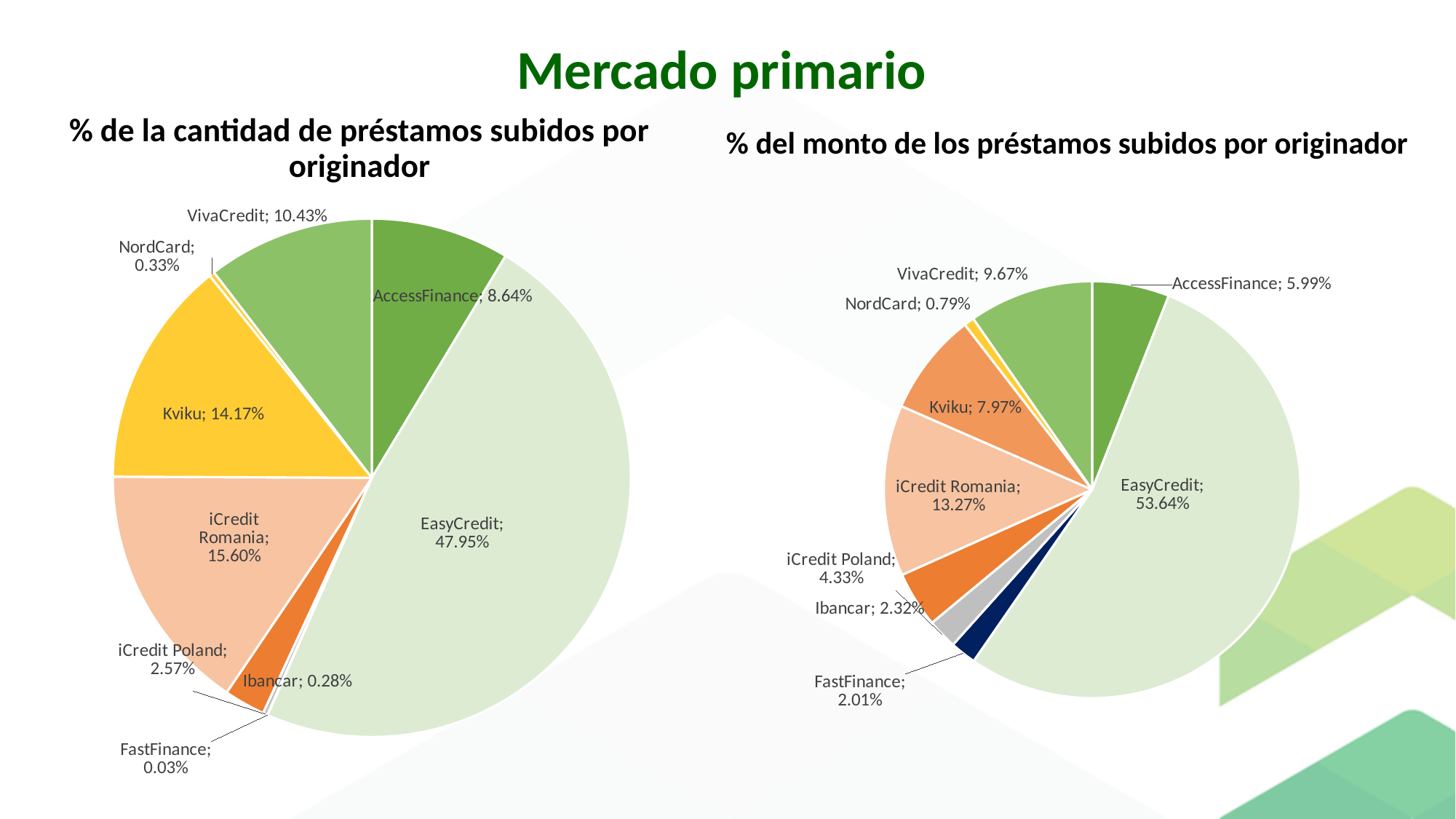
In the left chart, '% de la cantidad de préstamos subidos por originador', how many slices does the pie have? 9 In the left chart, '% de la cantidad de préstamos subidos por originador', what is the share for FastFinance? 0.03% What kind of chart is the left chart, '% de la cantidad de préstamos subidos por originador'? Pie chart In the right chart, '% del monto de los préstamos subidos por originador', what is the share for EasyCredit? 53.64% In the right chart, '% del monto de los préstamos subidos por originador', which is larger, VivaCredit or Kviku? VivaCredit In the left chart, '% de la cantidad de préstamos subidos por originador', which originator has the largest slice? EasyCredit In the right chart, '% del monto de los préstamos subidos por originador', which originator has the smallest slice? NordCard In the right chart, '% del monto de los préstamos subidos por originador', what is the share for iCredit Poland? 4.33% In the left chart, '% de la cantidad de préstamos subidos por originador', which originator has the smallest slice? FastFinance In the left chart, '% de la cantidad de préstamos subidos por originador', what is the share for Kviku? 14.17% In the left chart, '% de la cantidad de préstamos subidos por originador', what is the difference between iCredit Romania and Kviku? 1.43% In the right chart, '% del monto de los préstamos subidos por originador', what is the difference between iCredit Romania and AccessFinance? 7.28%